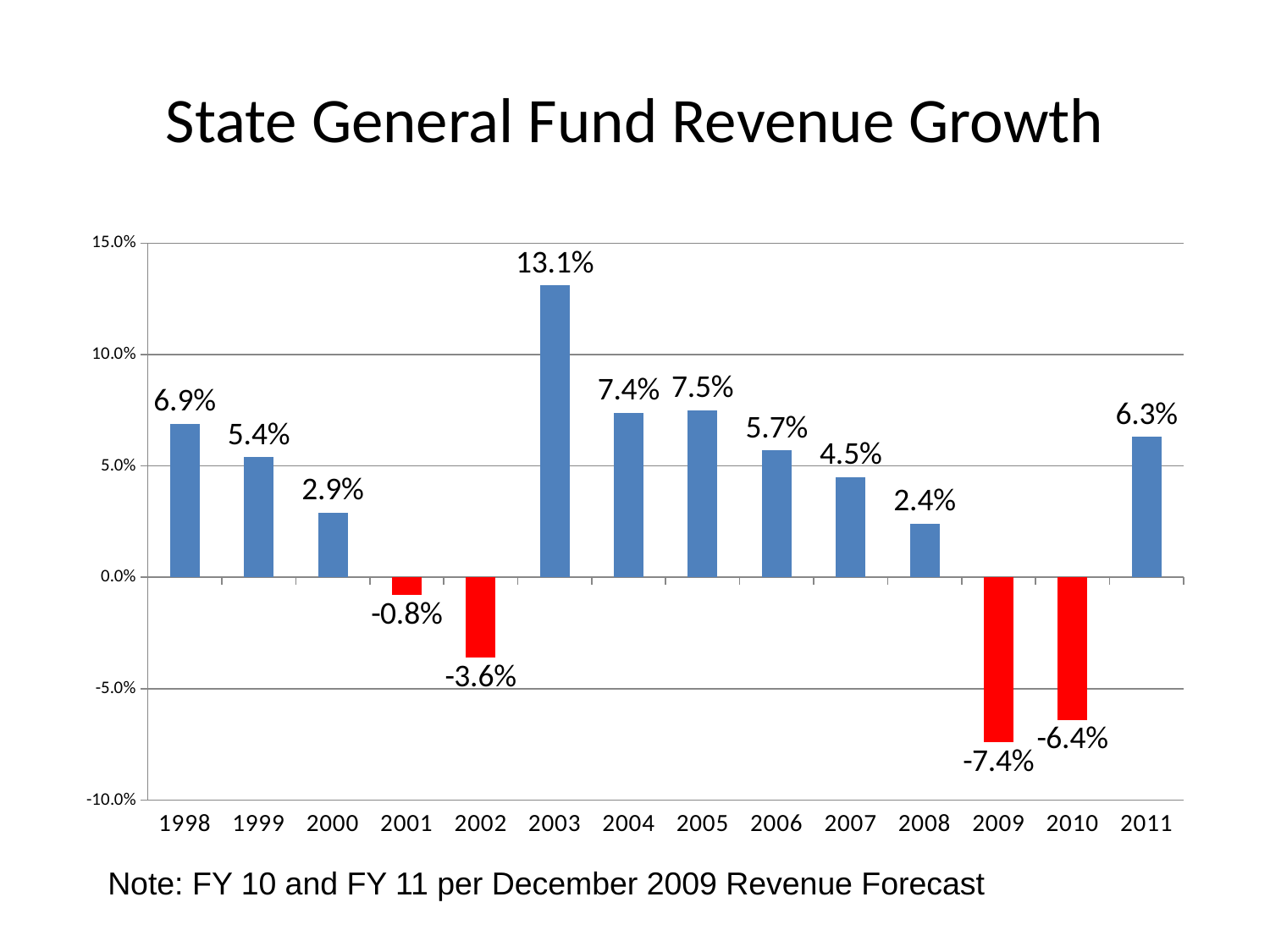
How many years are shown on the x axis? 14 What kind of chart is shown on the slide? bar chart What is the revenue growth value for 2003? 13.1% What is the revenue growth value for 2009? -7.4% Which year has the lowest revenue growth? 2009 Is the value for 2011 greater or less than 5.0%? greater Which year has the highest revenue growth? 2003 What is the difference between the revenue growth in 2003 and 2004? 5.7% What is the revenue growth value for 1998? 6.9% What is the title of the chart? State General Fund Revenue Growth Do the values rise or fall from 2005 to 2008? fall Which year has higher revenue growth, 1999 or 2006? 2006